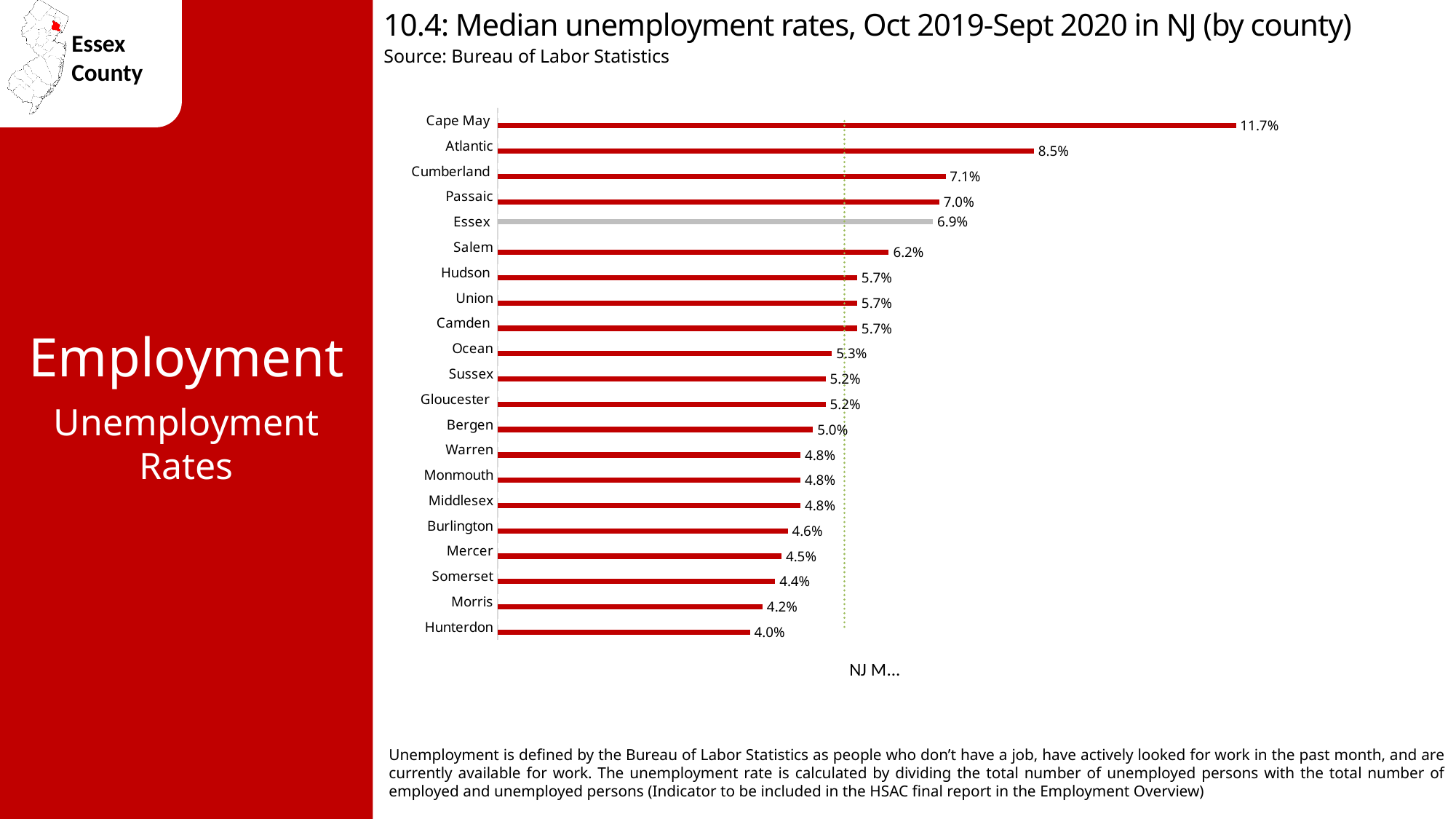
What is the median unemployment rate for Cape May? 11.7% Which has a higher median unemployment rate, Salem or Bergen? Salem What is the difference between the median unemployment rates of Essex and Hunterdon? 2.9% What kind of chart is used to show the median unemployment rates? Bar chart Which county's bar is shown in grey rather than red? Essex What is the median unemployment rate for Hunterdon? 4.0% Which county has the lowest median unemployment rate? Hunterdon What is the difference between the median unemployment rates of Cape May and Atlantic? 3.2% What is the source cited for the chart? Bureau of Labor Statistics What is the median unemployment rate for Essex County? 6.9% Which county has the highest median unemployment rate? Cape May How many counties are shown in the chart? 21